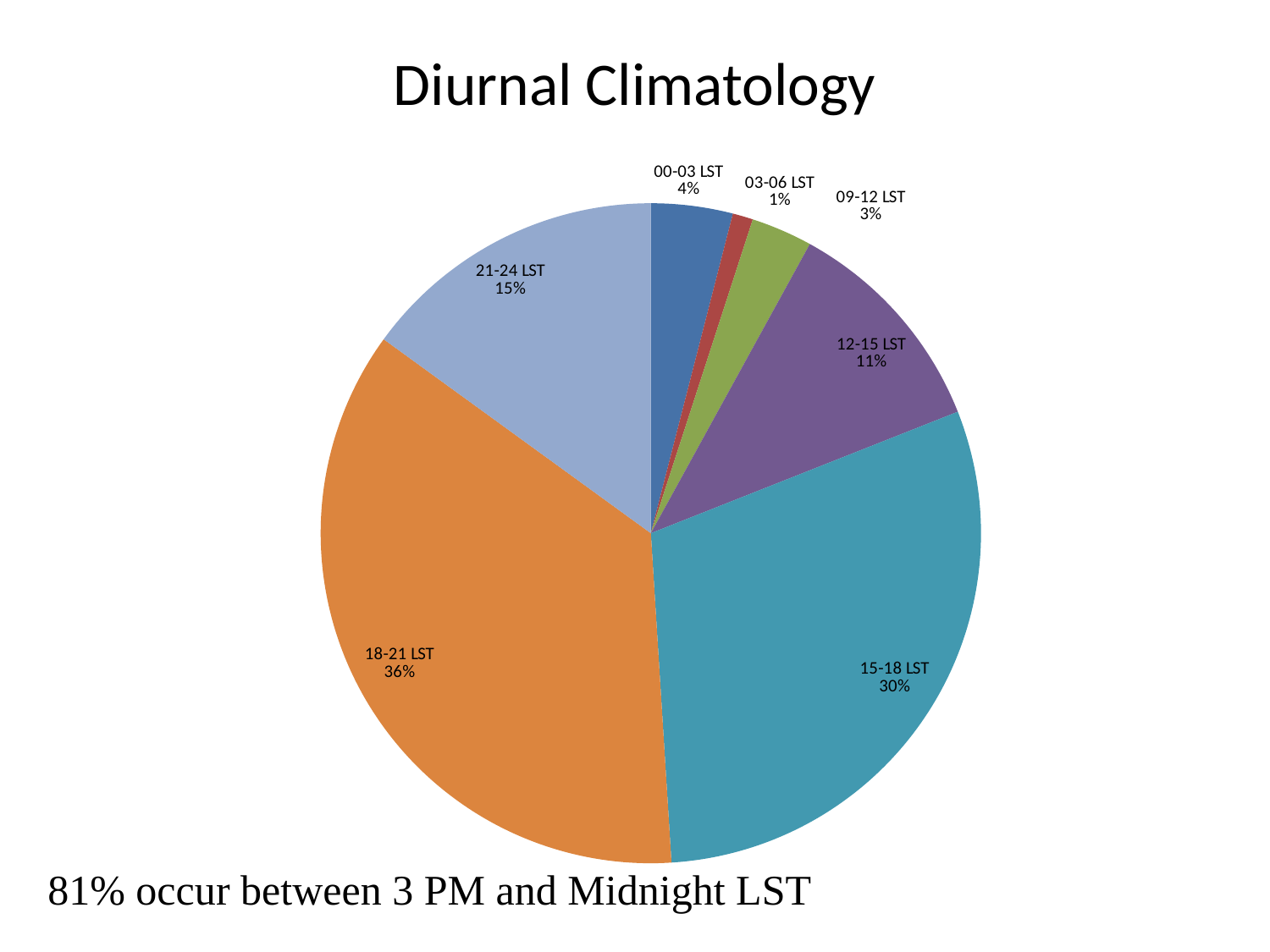
What share of the pie does the 15-18 LST slice represent? 30% What kind of chart is shown on the slide? pie chart What is the title of the chart? Diurnal Climatology What is the value shown for 21-24 LST? 15% What is the value shown for 03-06 LST? 1% What is the difference between the 18-21 LST share and the 15-18 LST share? 6% What is the value shown for 12-15 LST? 11% Which time period has the largest slice of the pie? 18-21 LST How many slices does the pie chart have? 7 Which time period has the smallest slice of the pie? 03-06 LST Which is larger, the share for 21-24 LST or the share for 12-15 LST? 21-24 LST What share of the pie does the 18-21 LST slice represent? 36%